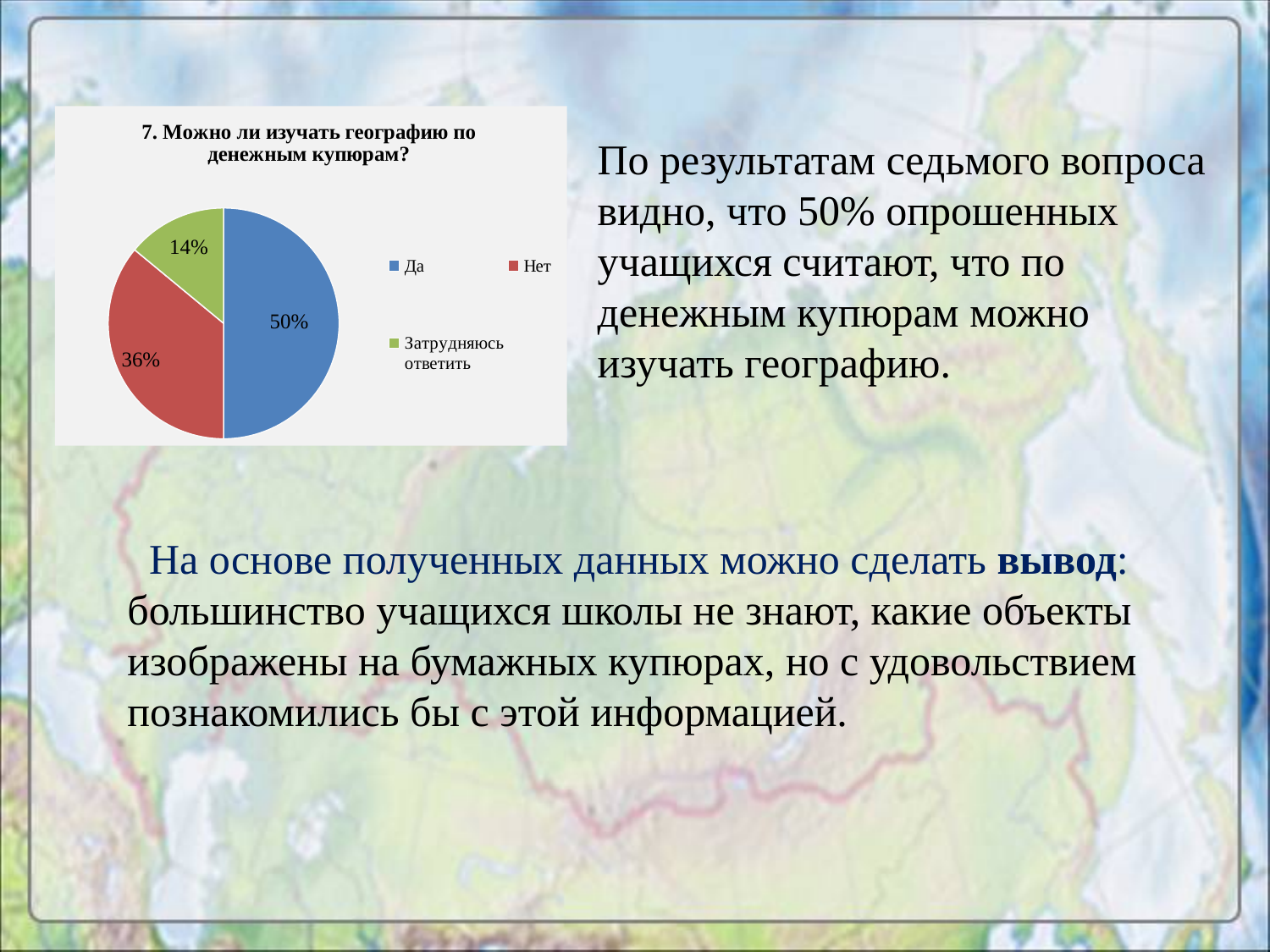
What is the difference in percentage points between "Да" and "Нет"? 14% How many entries does the legend list? 3 What kind of chart is shown on the slide? pie chart What is the title of the chart? 7. Можно ли изучать географию по денежным купюрам? Which category has the smallest slice? Затрудняюсь ответить What share of the pie does "Затрудняюсь ответить" take? 14% What share of the pie does "Нет" take? 36% What colour is the "Да" slice? blue How many slices does the pie chart have? 3 Which category has the largest slice? Да What share of the pie does "Да" take? 50% Which is larger, the share for "Нет" or the share for "Затрудняюсь ответить"? Нет